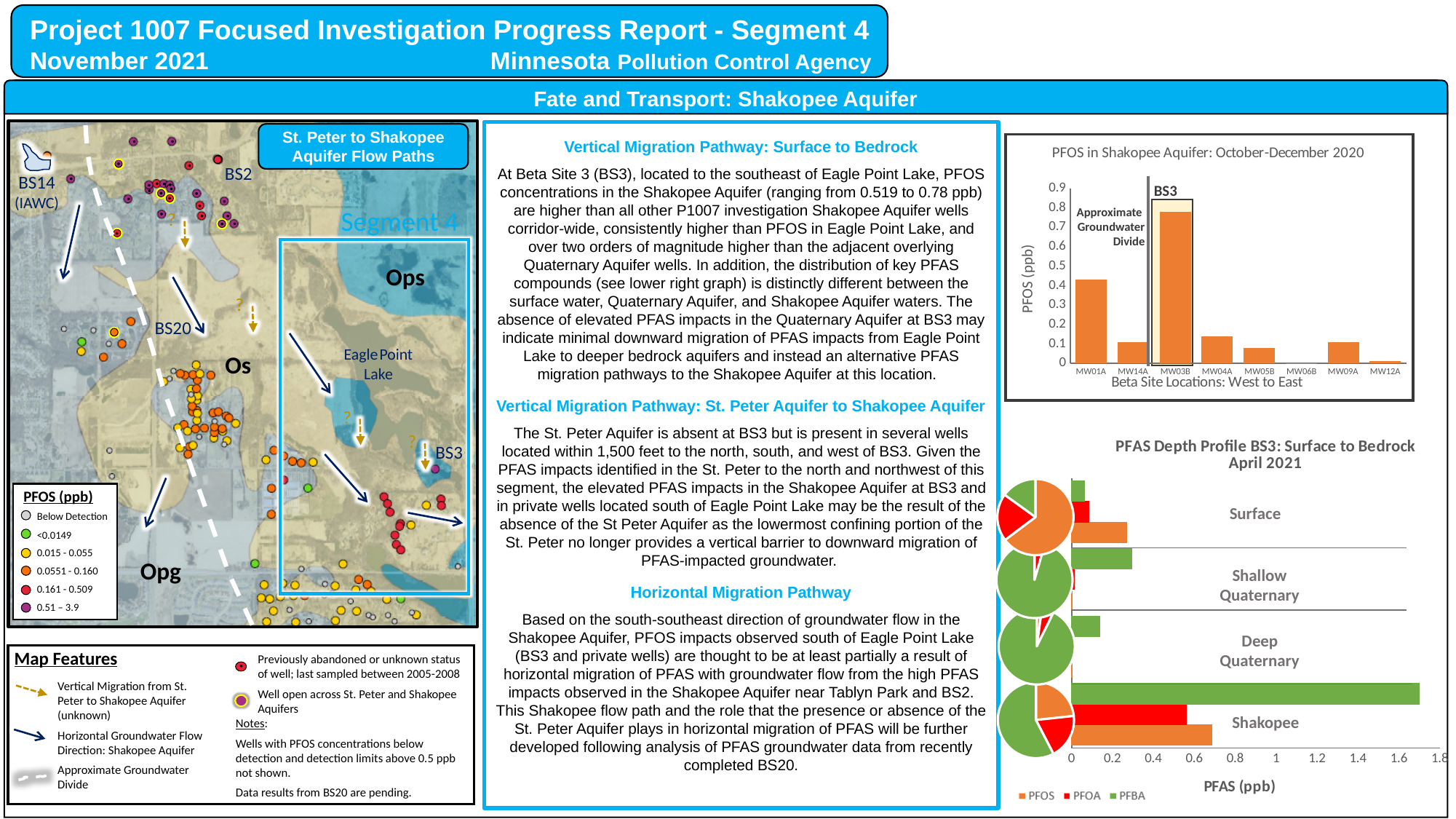
In the chart titled 'PFOS in Shakopee Aquifer: October-December 2020', which well location has the highest PFOS value? MW03B In the chart titled 'PFAS Depth Profile BS3: Surface to Bedrock April 2021', how many depth categories are shown? 4 What kind of chart is 'PFAS Depth Profile BS3: Surface to Bedrock April 2021'? bar chart In the chart titled 'PFAS Depth Profile BS3: Surface to Bedrock April 2021', how many series does the legend list? 3 In the chart titled 'PFAS Depth Profile BS3: Surface to Bedrock April 2021', is the PFBA value for Shakopee greater or less than 1.4? greater In the chart titled 'PFOS in Shakopee Aquifer: October-December 2020', how many well locations are shown on the x axis? 8 In the chart titled 'PFAS Depth Profile BS3: Surface to Bedrock April 2021', which depth category has the highest PFBA value? Shakopee In the chart titled 'PFOS in Shakopee Aquifer: October-December 2020', what is the label of the y axis? PFOS (ppb) In the chart titled 'PFOS in Shakopee Aquifer: October-December 2020', which is larger, the value for MW01A or the value for MW04A? MW01A In the chart titled 'PFOS in Shakopee Aquifer: October-December 2020', is the value for MW03B greater or less than 0.7? greater In the chart titled 'PFOS in Shakopee Aquifer: October-December 2020', is the value for MW14A greater or less than 0.2? less